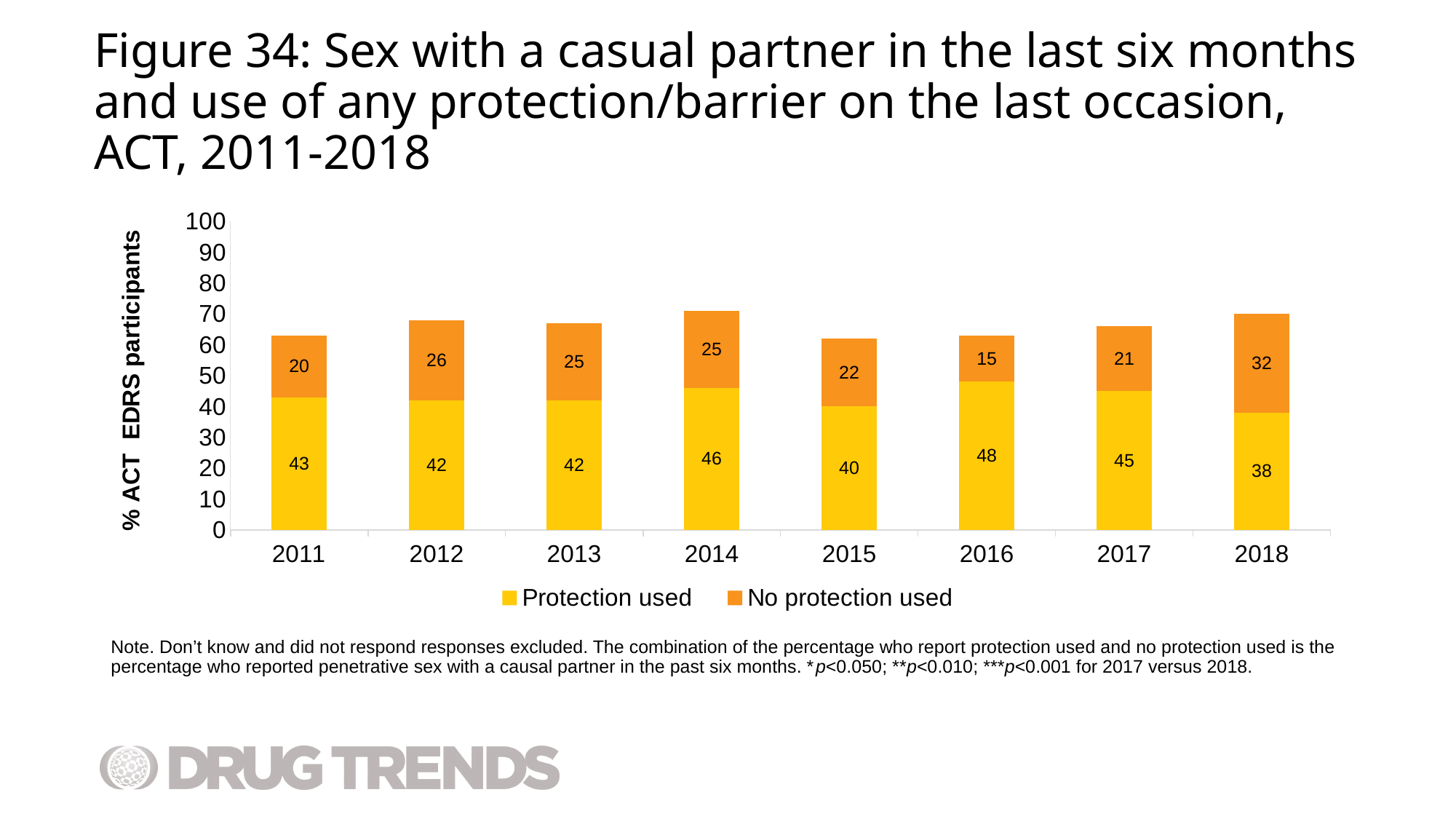
Which year has the lowest value for Protection used? 2018 Which is larger: Protection used in 2014 or Protection used in 2015? 2014 What is the difference between the No protection used values for 2018 and 2017? 11 What is the value for No protection used in 2018? 32 What is the value for Protection used in 2016? 48 What kind of chart is shown on the slide? Stacked bar chart Which year has the highest value for Protection used? 2016 How many series does the legend list? 2 Which year has the lowest value for No protection used? 2016 What is the total of the stacked bar for 2014? 71 How many years are shown on the x axis? 8 What is the value for Protection used in 2011? 43